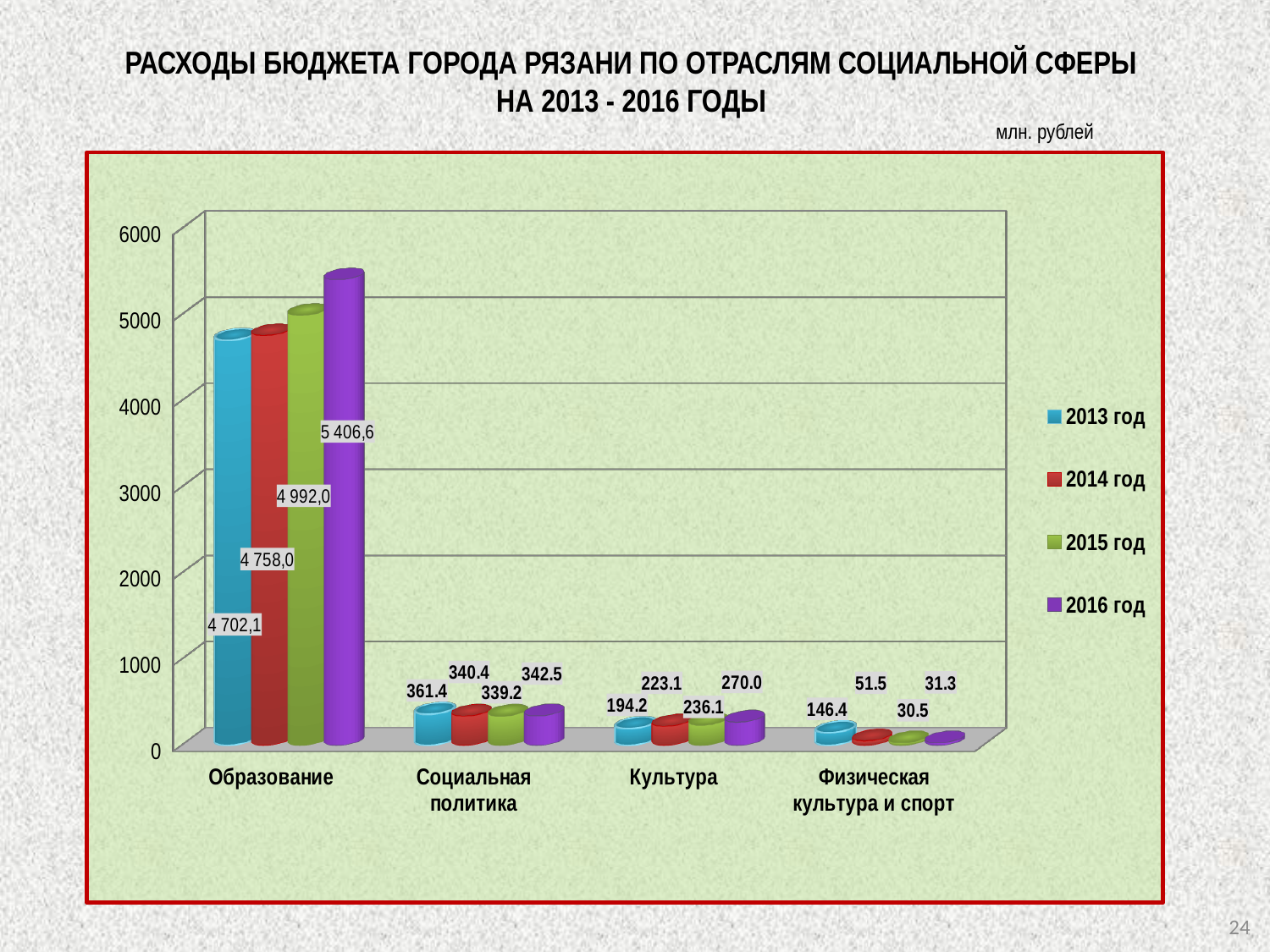
What is the value for Культура in 2013 год? 194.2 Which is larger for Культура: the 2014 год value or the 2016 год value? 2016 год What is the difference between the 2016 год and 2013 год values for Образование? 704,5 What is the value for Образование in 2016 год? 5 406,6 Do the values for Образование rise or fall from 2013 год to 2016 год? rise Which category has the highest value in 2016 год? Образование What is the value for Физическая культура и спорт in 2015 год? 30.5 How many categories are shown on the x axis? 4 What is the difference between the 2013 год and 2014 год values for Физическая культура и спорт? 94.9 How many series does the legend list? 4 What is the value for Социальная политика in 2014 год? 340.4 Which category has the lowest value in 2013 год? Физическая культура и спорт